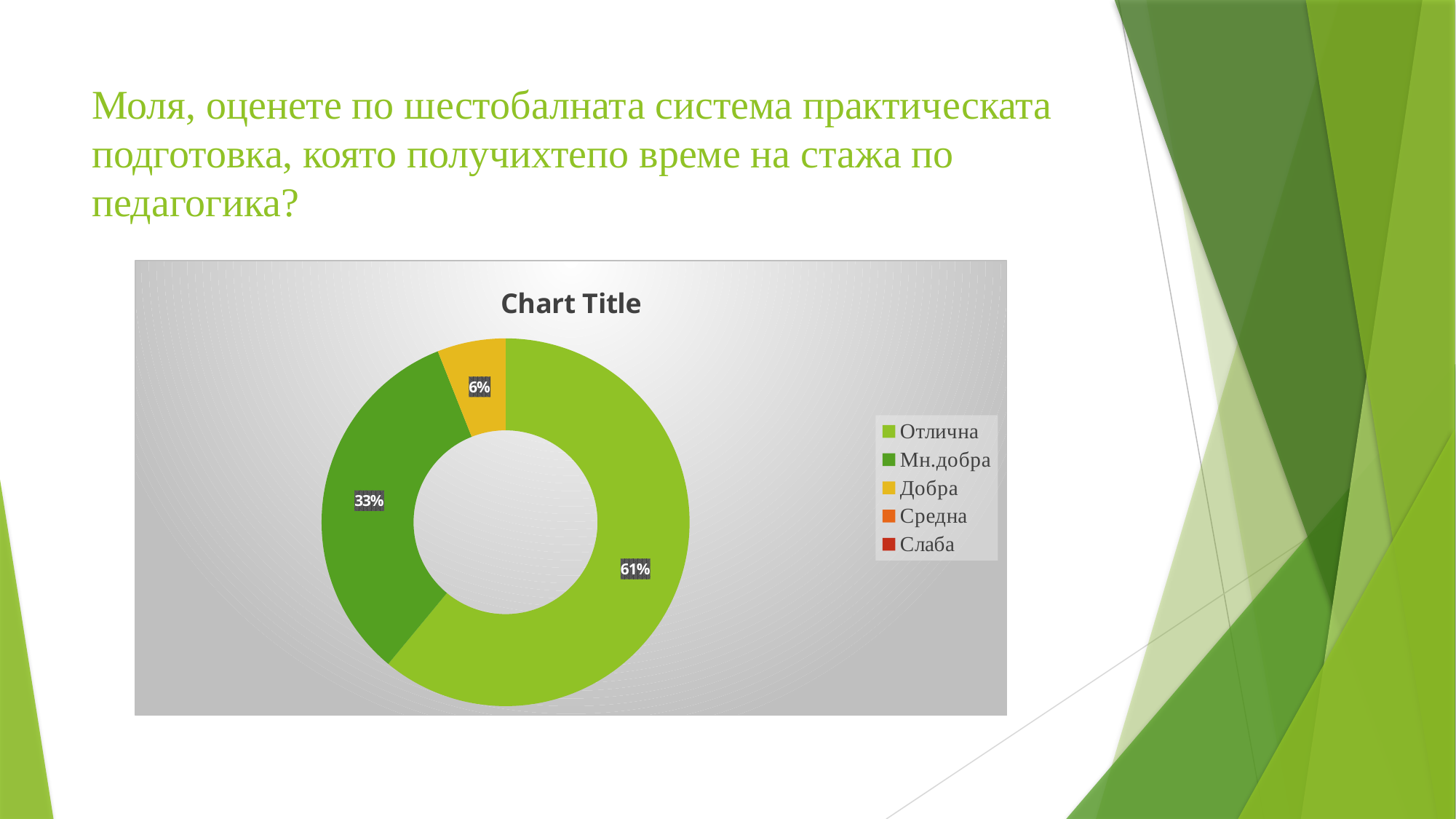
What share of the doughnut chart is labelled Добра? 6% Which is larger, the share for Мн.добра or the share for Добра? Мн.добра What is the difference in percentage points between the Отлична and Мн.добра shares? 28 What colour is the Добра segment of the chart? Yellow What is the difference in percentage points between the Мн.добра and Добра shares? 27 What is the title shown above the chart? Chart Title Which of the labelled categories has the smallest share of the chart? Добра What share of the doughnut chart is labelled Отлична? 61% What share of the doughnut chart is labelled Мн.добра? 33% What kind of chart is shown on the slide? Doughnut chart Which category has the largest share of the chart? Отлична How many entries does the chart legend list? 5